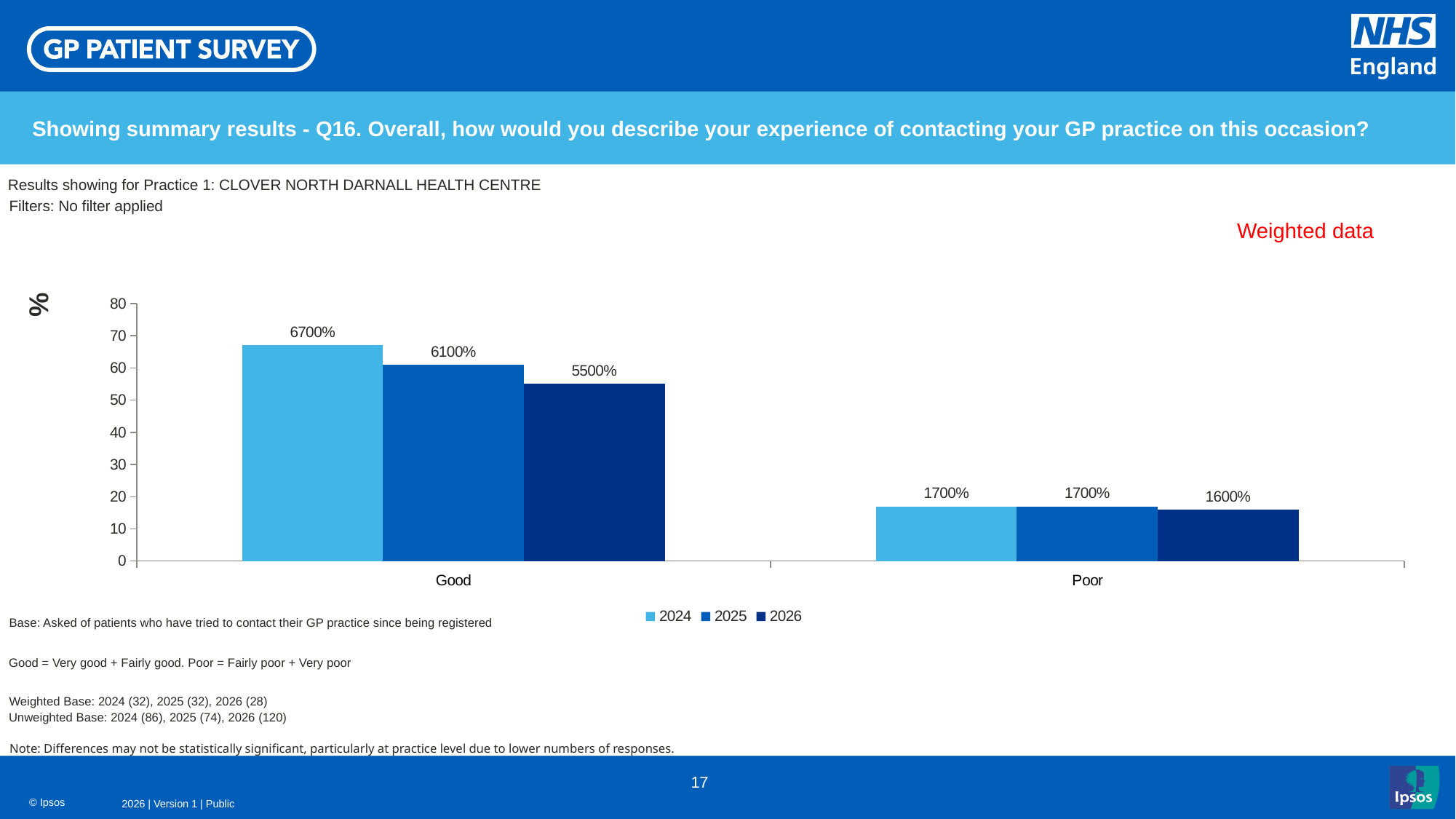
Is the 2024 bar for Poor greater or less than 20 on the axis? less How many categories are shown on the x axis? 2 Which year has the shortest bar for Poor? 2026 What is the data label on the 2025 bar for Poor? 1700% What is the data label on the 2026 bar for Good? 5500% How many series does the legend list? 3 Which year has the tallest bar for Good? 2024 What is the data label on the 2026 bar for Poor? 1600% Which is larger for 2025: the Good bar or the Poor bar? Good What is the data label on the 2024 bar for Good? 6700% Is the 2026 bar for Good greater or less than 50 on the axis? greater Do the Good bars rise or fall from 2024 to 2026? fall